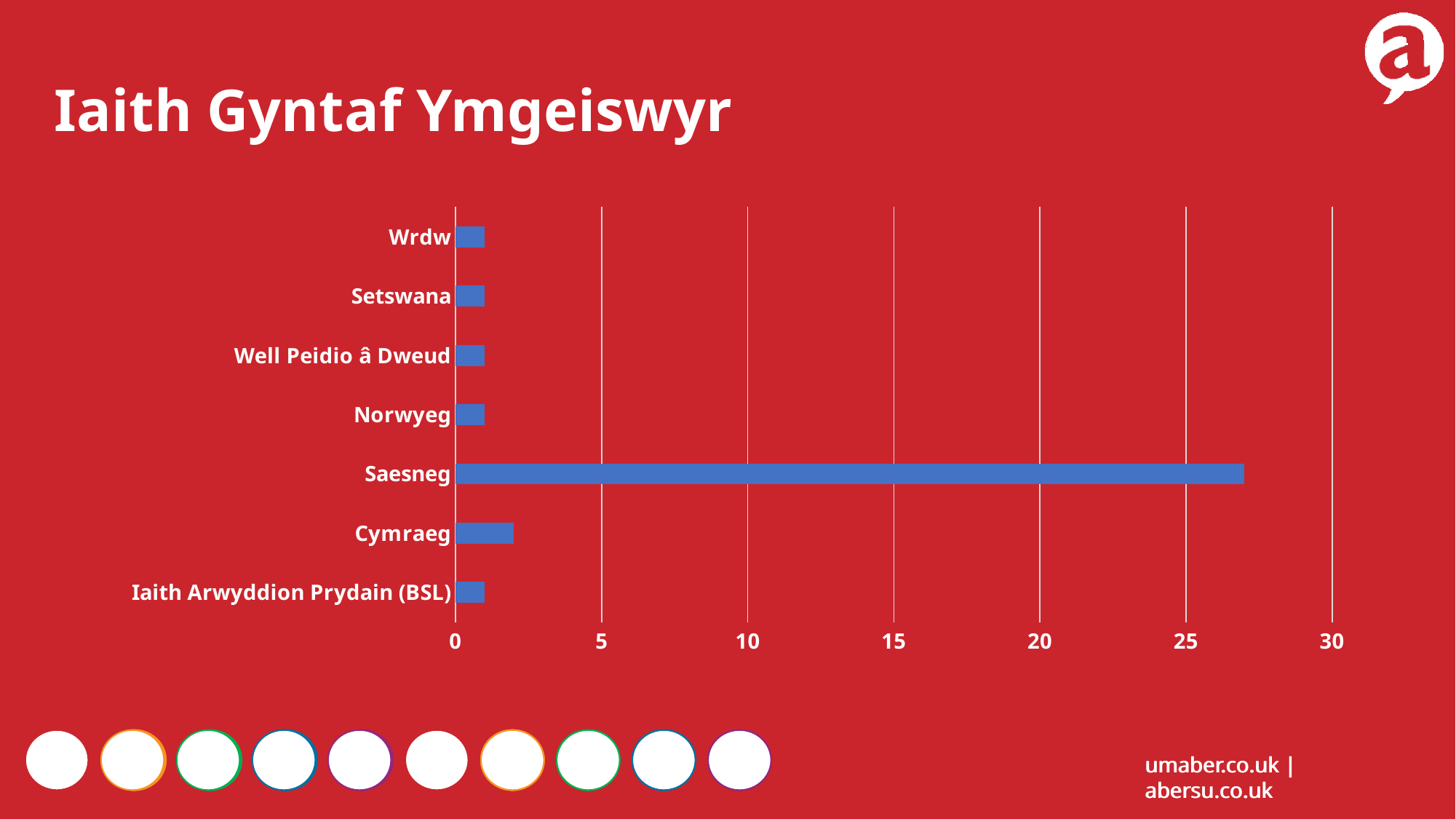
What kind of chart is shown on the slide? bar chart Is the value for Saesneg greater or less than 30? less Which category has the highest value? Saesneg Which is larger, the value for Cymraeg or the value for Norwyeg? Cymraeg What is the title of the chart? Iaith Gyntaf Ymgeiswyr Which is larger, the value for Saesneg or the value for Cymraeg? Saesneg Is the value for Saesneg greater or less than 25? greater Is the value for Wrdw greater or less than 5? less How many categories are plotted in the chart? 7 What is the highest value shown on the x axis? 30